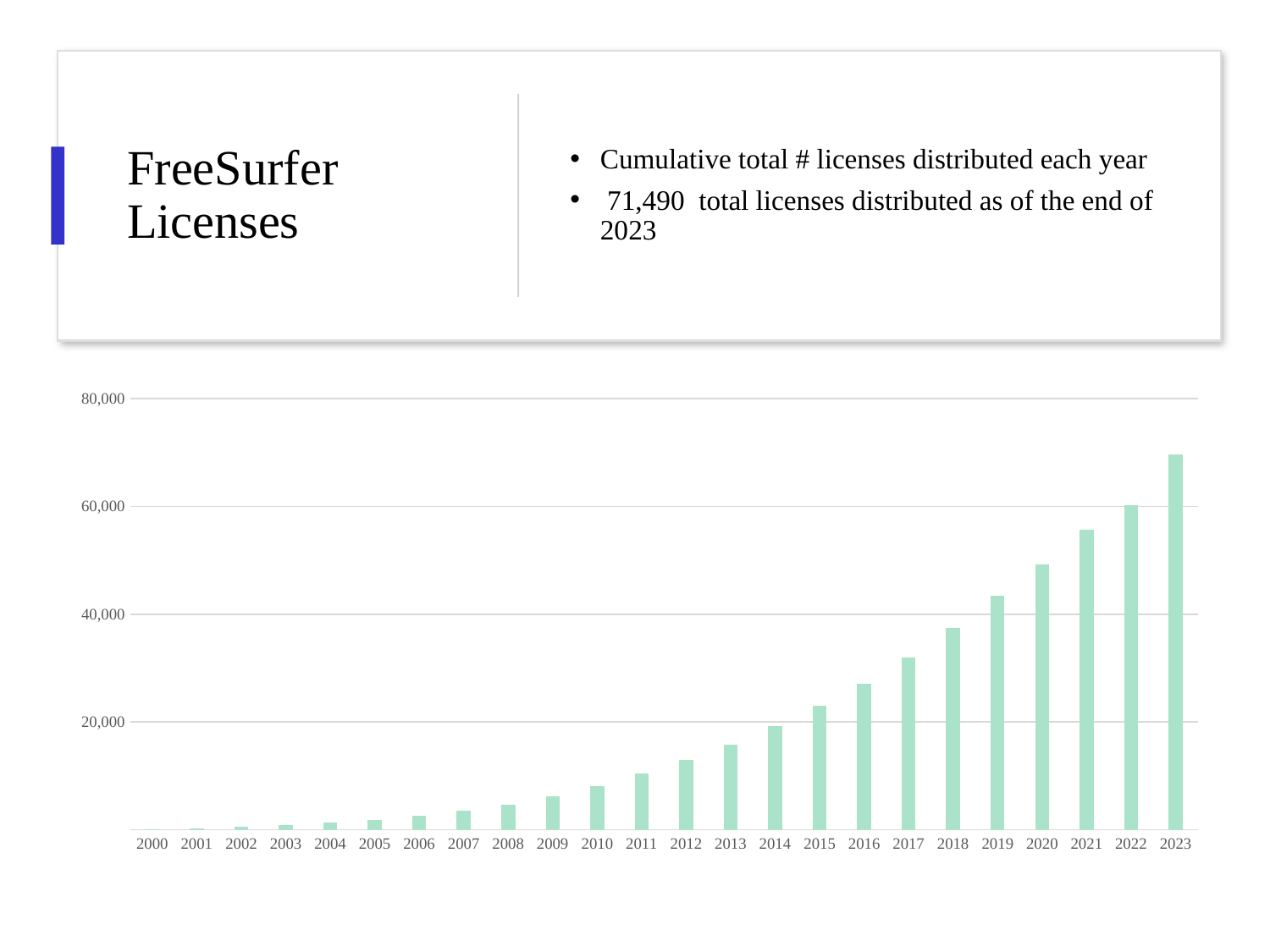
Do the values rise or fall from 2000 to 2023? rise Is the value for 2023 greater or less than 60,000? greater Which is larger, the value for 2015 or the value for 2023? 2023 Is the value for 2018 greater or less than 40,000? less Is the value for 2016 greater or less than 20,000? greater How many years are shown on the x axis of the chart? 24 Which year has the highest bar in the chart? 2023 Which year has the lowest bar in the chart? 2000 What kind of chart is shown on the slide? bar chart